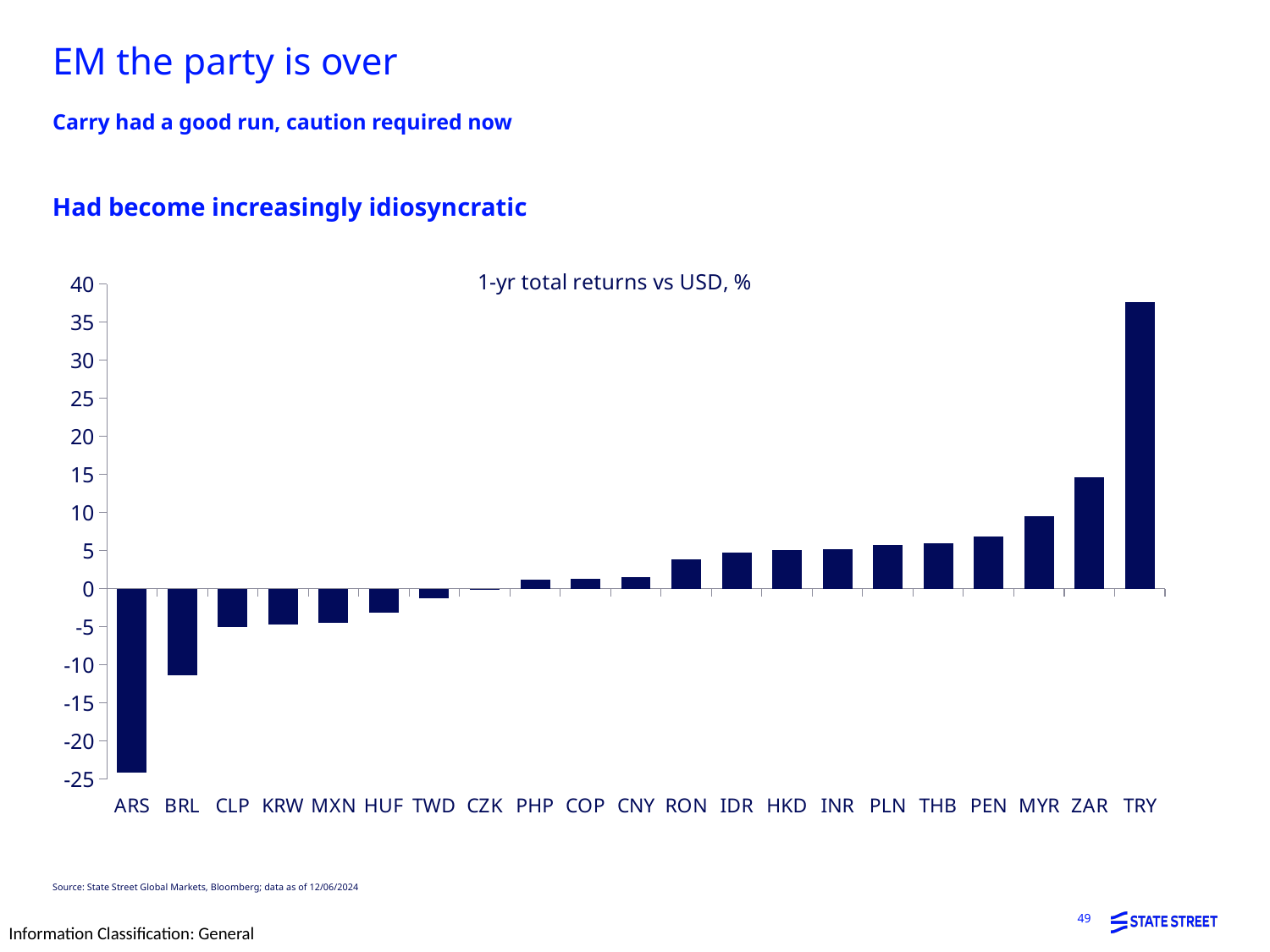
Do the values generally rise or fall moving from left to right along the x axis? rise Is the value for ARS greater or less than -20? less Which currency has the lowest 1-yr total return vs USD? ARS Which has the larger 1-yr total return vs USD, MYR or PEN? MYR What kind of chart is shown on the slide? bar chart Is the value for BRL greater or less than -10? less Is the value for ZAR greater or less than 10? greater How many currencies are plotted on the chart? 21 What is the title of the chart? 1-yr total returns vs USD, % Which currency has the highest 1-yr total return vs USD? TRY Which has the larger 1-yr total return vs USD, HUF or CLP? HUF